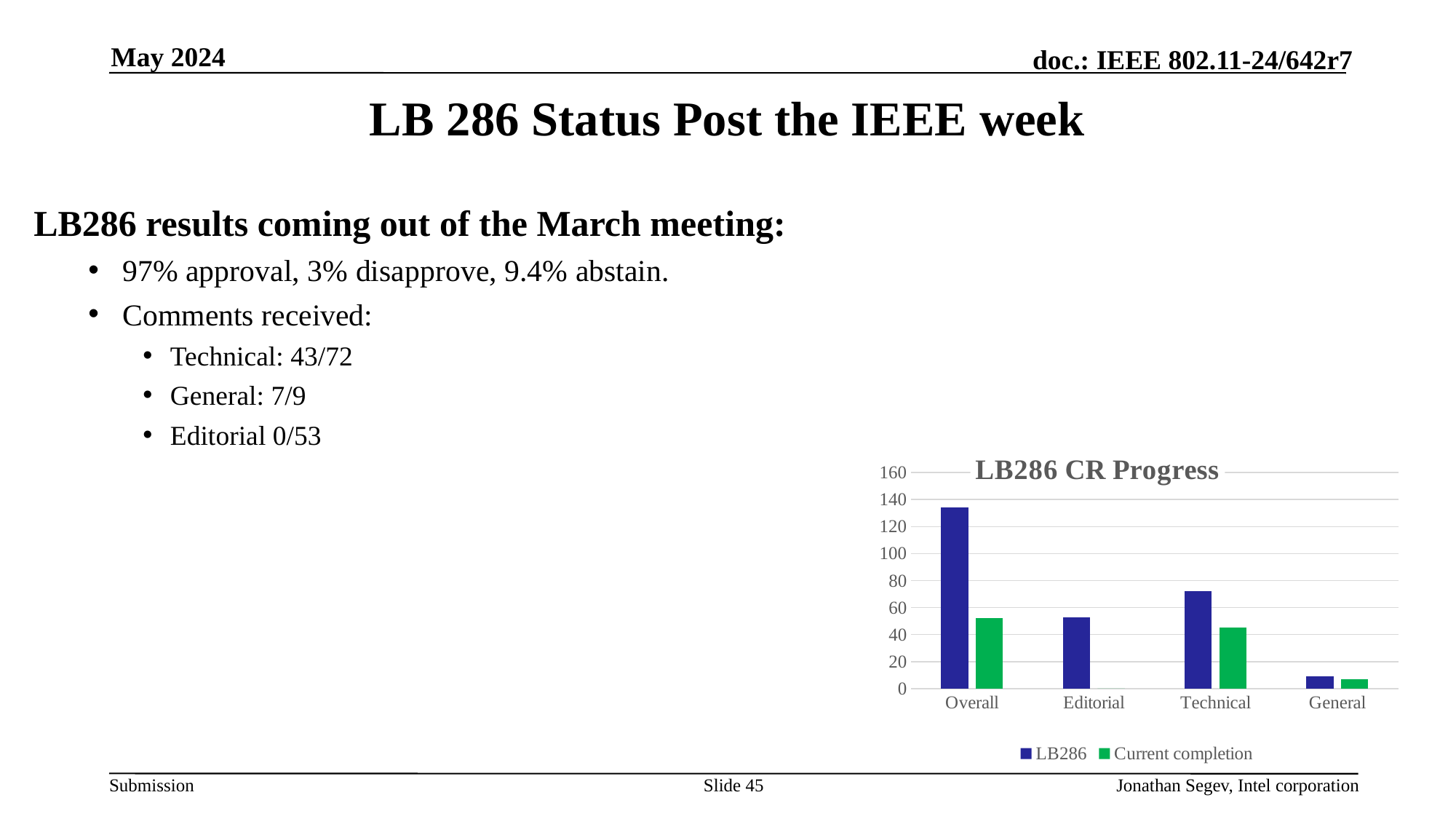
Is the LB286 value for Technical greater or less than 60? greater Is the LB286 value for Overall greater or less than 120? greater Is the Current completion value for Overall greater or less than 60? less How many series does the chart legend list? 2 Which category has the lowest LB286 value in the chart? General What kind of chart is shown on the slide? bar chart Which is larger, the LB286 value for Technical or the LB286 value for Editorial? Technical How many categories are shown on the x axis of the chart? 4 What is the title of the chart on the slide? LB286 CR Progress Which colour represents the Current completion series in the chart? green Which category has the highest LB286 value in the chart? Overall